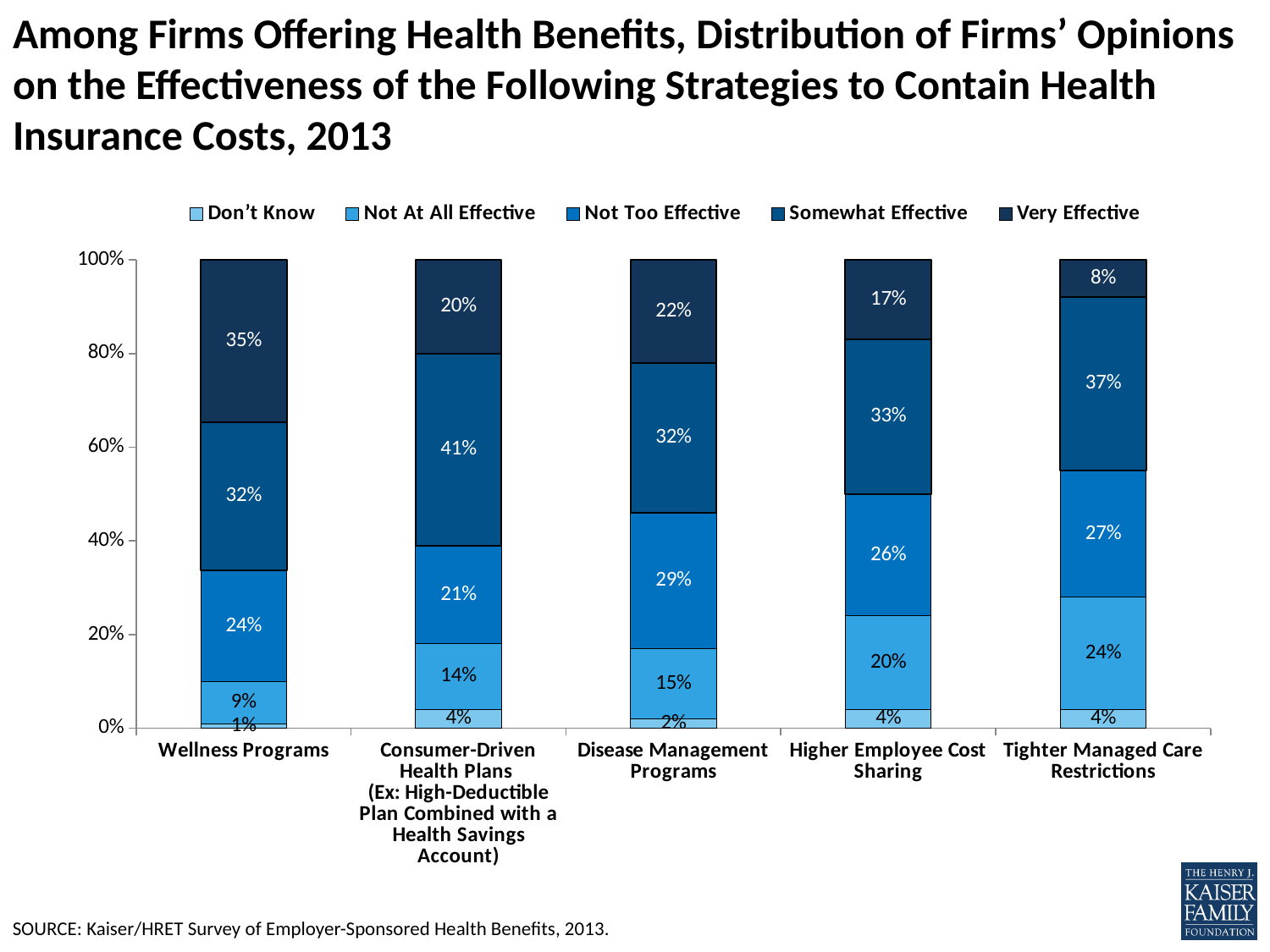
What percentage of firms rated Wellness Programs as Very Effective? 35% Which strategy has the lowest share of firms rating it Very Effective? Tighter Managed Care Restrictions What is the difference between the Very Effective share for Wellness Programs and for Tighter Managed Care Restrictions? 27 percentage points What kind of chart is shown on the slide? Stacked bar chart What percentage of firms answered Don't Know for Disease Management Programs? 2% What is the source cited at the bottom of the slide? Kaiser/HRET Survey of Employer-Sponsored Health Benefits, 2013 Which strategy has the highest share of firms rating it Very Effective? Wellness Programs Which has a larger Not Too Effective share: Disease Management Programs or Higher Employee Cost Sharing? Disease Management Programs How many strategies are shown on the x axis? 5 How many series does the legend list? 5 What percentage of firms rated Consumer-Driven Health Plans as Somewhat Effective? 41% What percentage of firms said Tighter Managed Care Restrictions are Not At All Effective? 24%